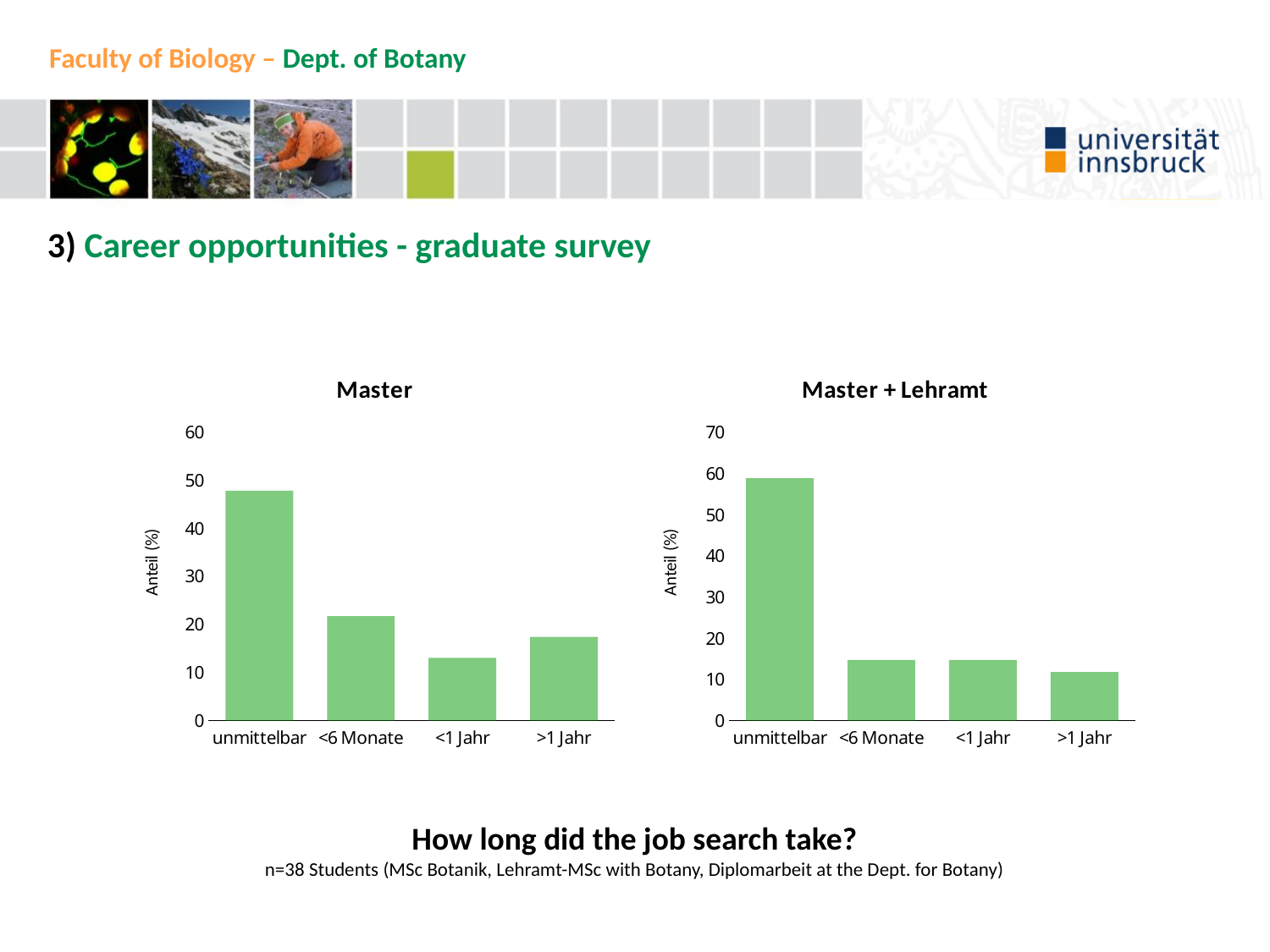
In the "Master" chart, is the value for unmittelbar greater or less than 40? greater In the "Master" chart, which category has the highest value? unmittelbar In the "Master" chart, is the value for <6 Monate greater or less than 30? less In the "Master" chart, is the value for >1 Jahr greater or less than 10? greater How many categories are shown on the x axis of the "Master" chart? 4 In the "Master" chart, which category has the lowest value? <1 Jahr What kind of chart is the "Master + Lehramt" chart? bar chart In the "Master + Lehramt" chart, which category has the highest value? unmittelbar In the "Master + Lehramt" chart, which is larger, the value for unmittelbar or the value for <1 Jahr? unmittelbar In the "Master" chart, which is larger, the value for <6 Monate or the value for >1 Jahr? <6 Monate